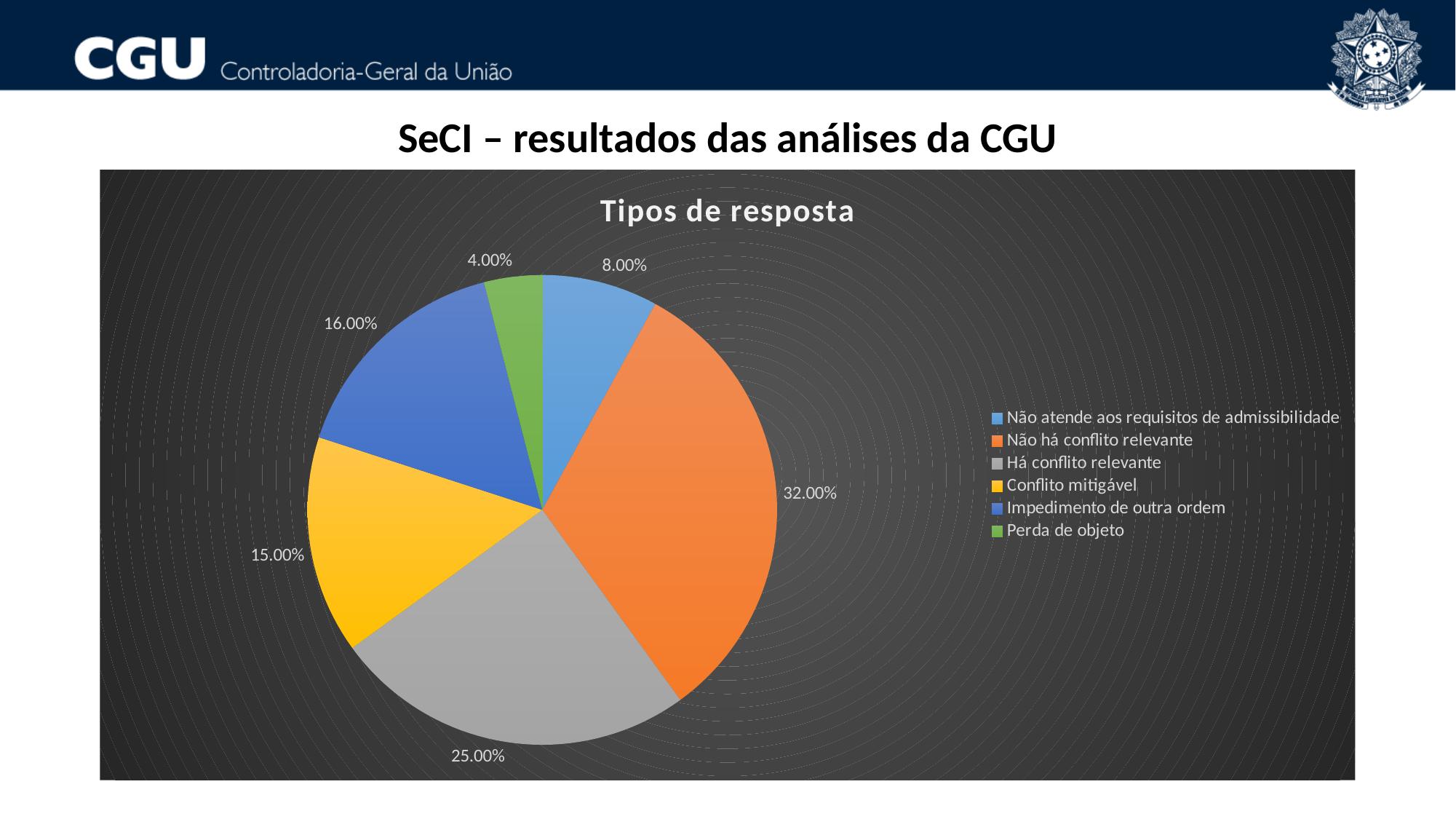
What share of the pie is 'Há conflito relevante'? 25.00% What share of the pie is 'Perda de objeto'? 4.00% What type of chart is shown on the slide? Pie chart How many categories does the legend list? 6 Which category has the largest slice of the pie? Não há conflito relevante Which category has the smallest slice of the pie? Perda de objeto What share of the pie is 'Conflito mitigável'? 15.00% What share of the pie is 'Não há conflito relevante'? 32.00% What colour is the slice for 'Conflito mitigável'? Yellow What is the title of the chart? Tipos de resposta Which is larger: 'Impedimento de outra ordem' or 'Não atende aos requisitos de admissibilidade'? Impedimento de outra ordem What is the difference between the shares of 'Não há conflito relevante' and 'Há conflito relevante'? 7.00%